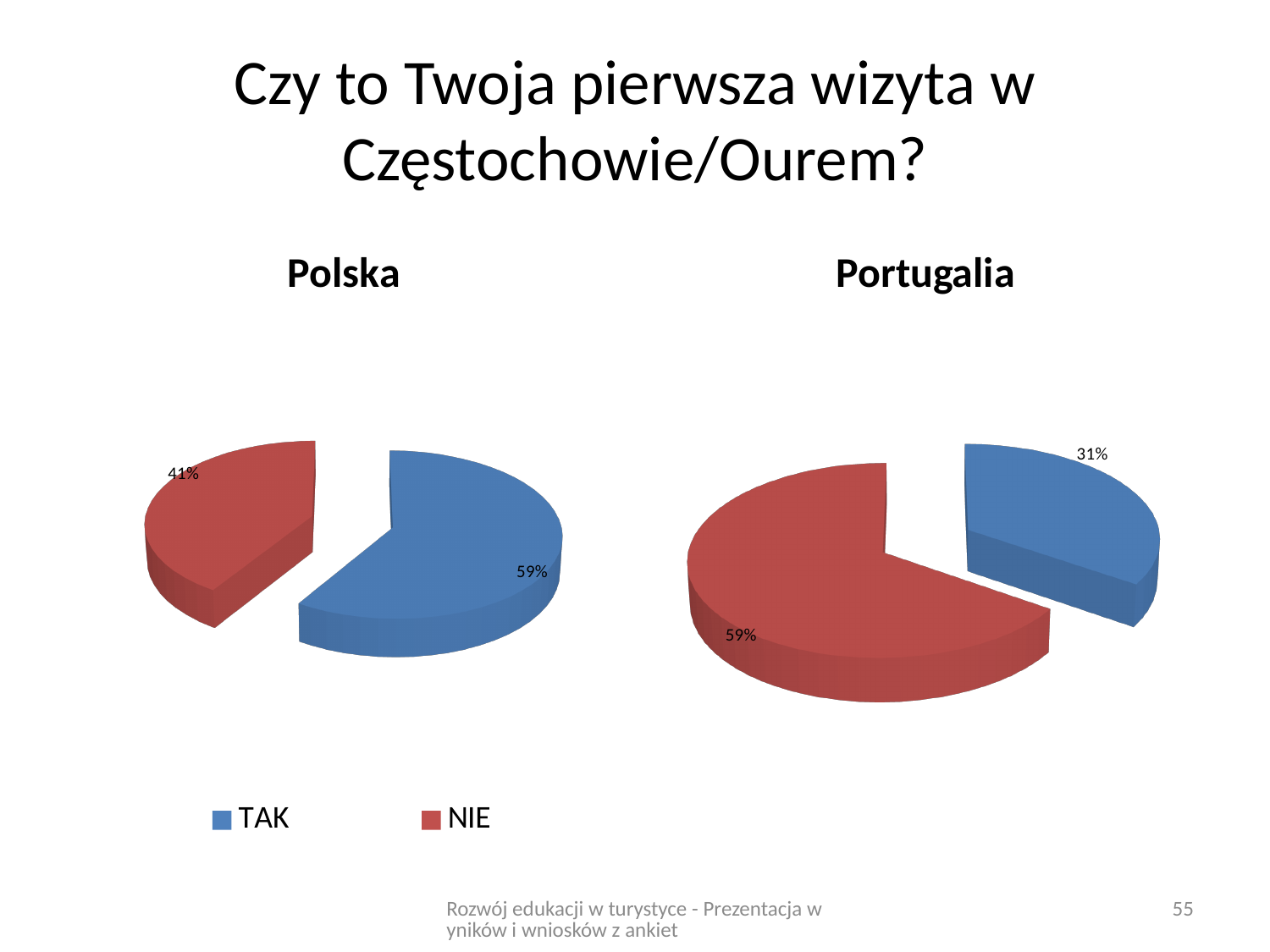
In the Portugalia chart, which answer has the smaller slice? TAK In the Portugalia chart, what share of respondents answered TAK? 31% Which colour represents NIE in the legend? red What kind of chart is the Polska chart? pie chart In the Polska chart, what is the difference between the TAK and NIE shares? 18% In the Polska chart, what share of respondents answered NIE? 41% In the Portugalia chart, what share of respondents answered NIE? 59% How many slices does the Portugalia pie chart have? 2 In the Polska chart, what share of respondents answered TAK? 59% In the Portugalia chart, what is the difference between the NIE and TAK shares? 28% In the Polska chart, which answer has the larger slice? TAK Is the TAK share larger in the Polska chart or in the Portugalia chart? Polska